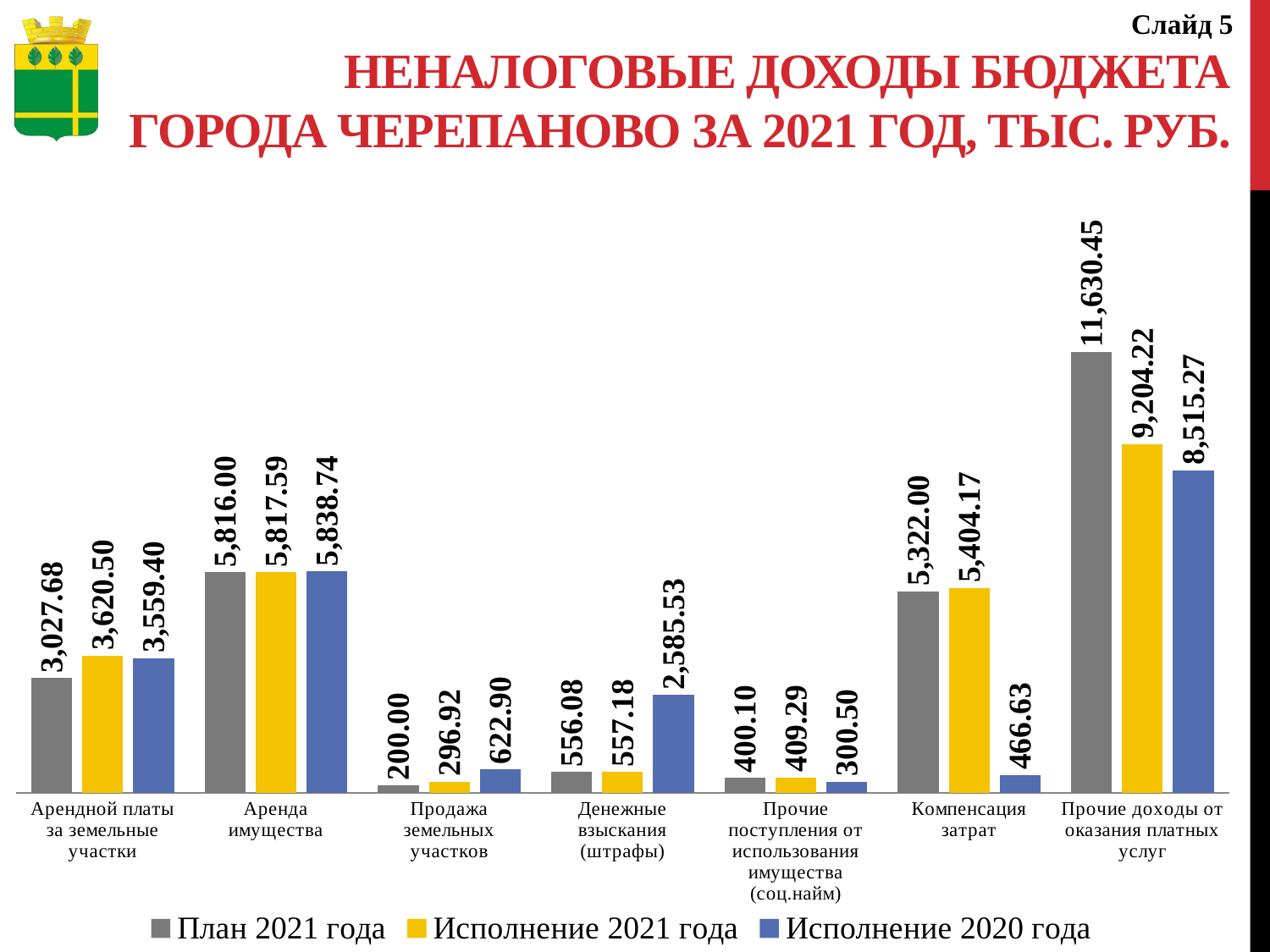
Which category has the highest value for "Исполнение 2021 года"? Прочие доходы от оказания платных услуг What is the value of "Исполнение 2021 года" for "Компенсация затрат"? 5,404.17 What is the title of the chart? НЕНАЛОГОВЫЕ ДОХОДЫ БЮДЖЕТА ГОРОДА ЧЕРЕПАНОВО ЗА 2021 ГОД, ТЫС. РУБ. What is the difference between "Исполнение 2021 года" and "Исполнение 2020 года" for "Компенсация затрат"? 4,937.54 For "Продажа земельных участков", which is larger: "Исполнение 2021 года" or "Исполнение 2020 года"? Исполнение 2020 года What is the value of "Исполнение 2020 года" for "Денежные взыскания (штрафы)"? 2,585.53 What is the difference between "План 2021 года" and "Исполнение 2021 года" for "Прочие доходы от оказания платных услуг"? 2,426.23 How many series does the legend list? 3 What type of chart is shown on the slide? Bar chart How many categories are shown on the x axis? 7 What is the value of "План 2021 года" for "Прочие доходы от оказания платных услуг"? 11,630.45 Which category has the lowest value for "План 2021 года"? Продажа земельных участков